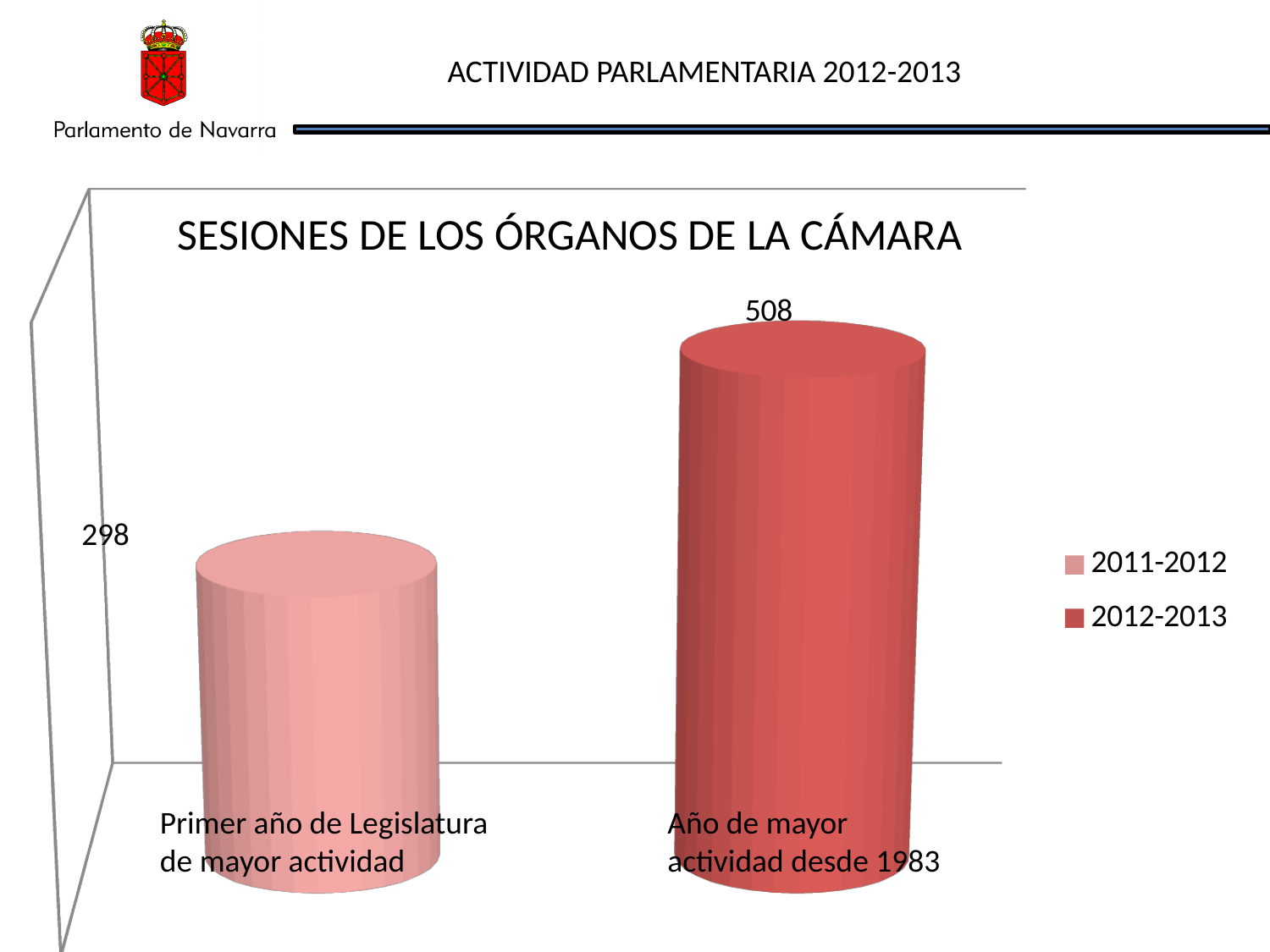
Which series has the highest value in the chart? 2012-2013 Which is larger, the value for 2011-2012 or the value for 2012-2013? 2012-2013 How many series does the legend list? 2 What is the value for 2011-2012 in the chart? 298 What text is written below the 2012-2013 bar? Año de mayor actividad desde 1983 Do the values rise or fall from 2011-2012 to 2012-2013? Rise What is the difference between the 2012-2013 value and the 2011-2012 value? 210 What is the value for 2012-2013 in the chart? 508 What is the title of the chart? SESIONES DE LOS ÓRGANOS DE LA CÁMARA What kind of chart is shown on the slide? Bar chart Which series has the lowest value in the chart? 2011-2012 How many bars are plotted in the chart? 2